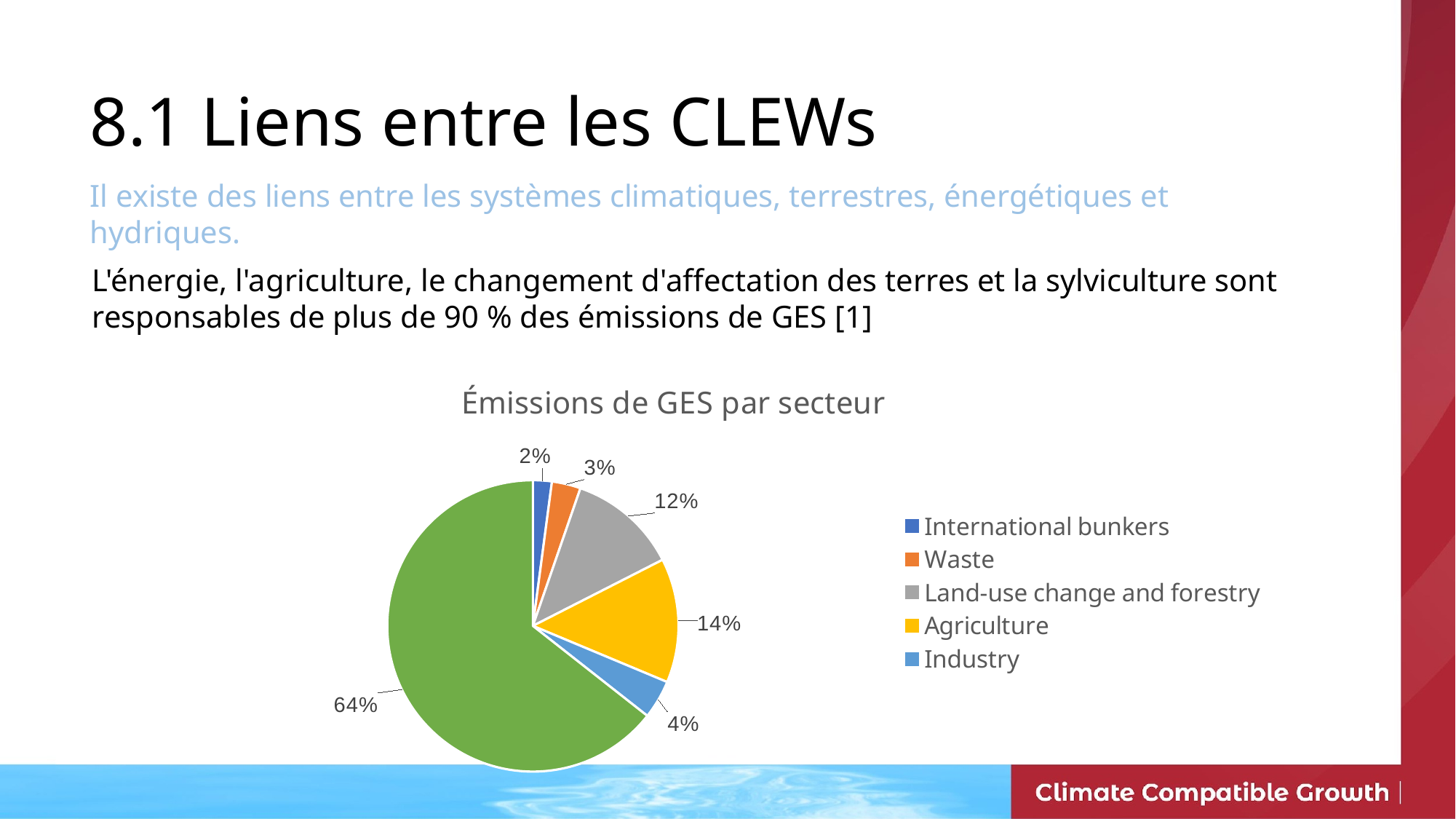
What is the largest percentage labelled on the pie chart? 64% What type of chart is shown on the slide? pie chart What percentage is shown for International bunkers? 2% What percentage is shown for Land-use change and forestry? 12% What share of GHG emissions does Agriculture account for in the pie chart? 14% What percentage is shown for Industry? 4% What is the difference in percentage points between Agriculture and Industry? 10 How many entries does the legend list? 5 Which has the larger share, Agriculture or Land-use change and forestry? Agriculture How many slices does the pie chart have? 6 What percentage is shown for Waste? 3% What is the title of the chart? Émissions de GES par secteur